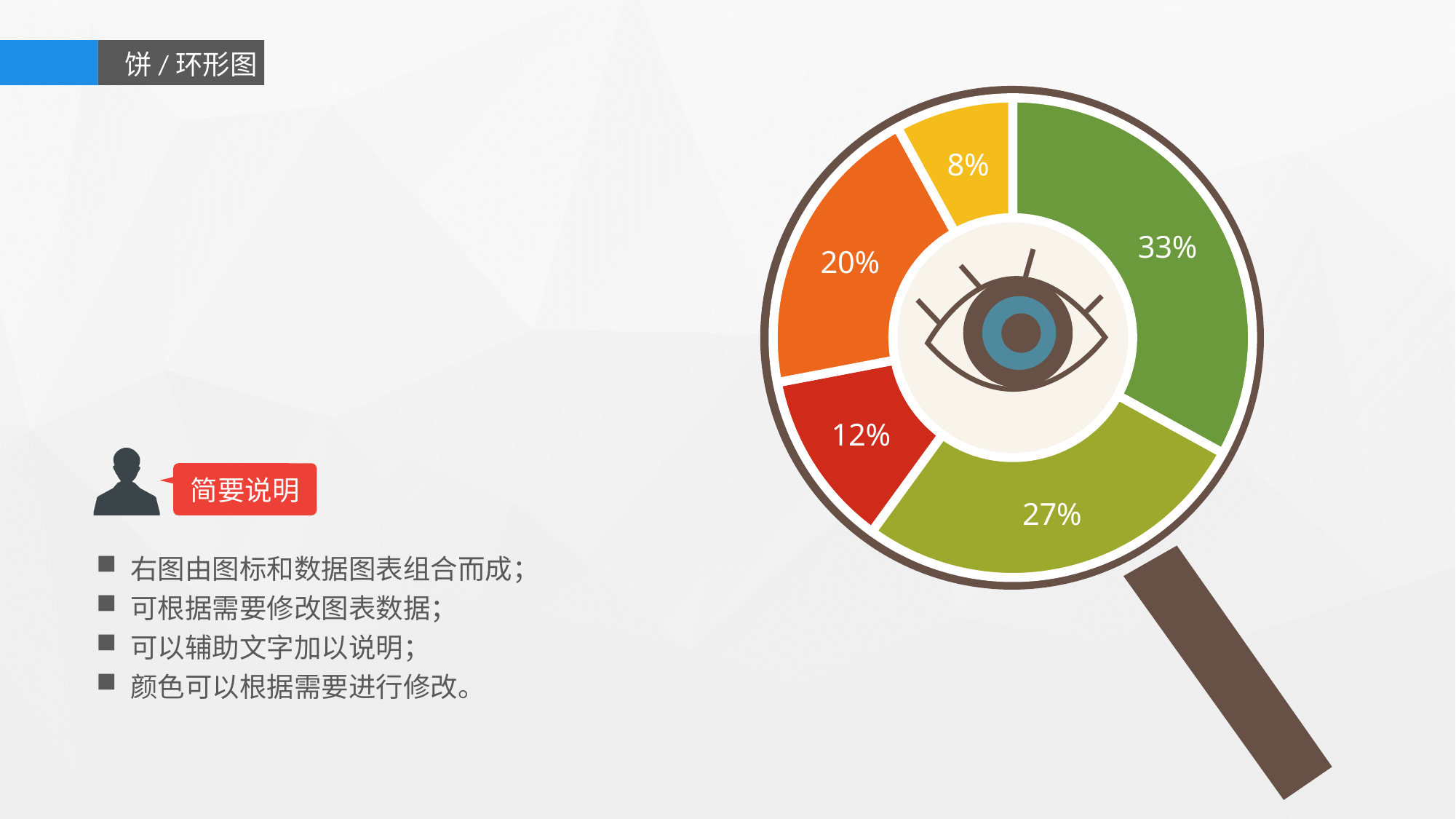
How many slices does the doughnut chart have? 5 What is the title shown in the header bar at the top left of the slide? 饼 / 环形图 What value is labelled on the orange slice of the doughnut chart? 20% What kind of chart is shown on the slide? Doughnut (ring) chart What value is labelled on the dark green slice of the doughnut chart? 33% What is the smallest percentage shown on the doughnut chart? 8% What value is labelled on the red slice of the doughnut chart? 12% What is the largest percentage shown on the doughnut chart? 33% What value is labelled on the yellow slice of the doughnut chart? 8% Which slice is larger, the orange slice or the red slice? The orange slice (20%) What value is labelled on the olive green slice at the bottom of the doughnut chart? 27% What is the difference between the largest slice (33%) and the smallest slice (8%)? 25%